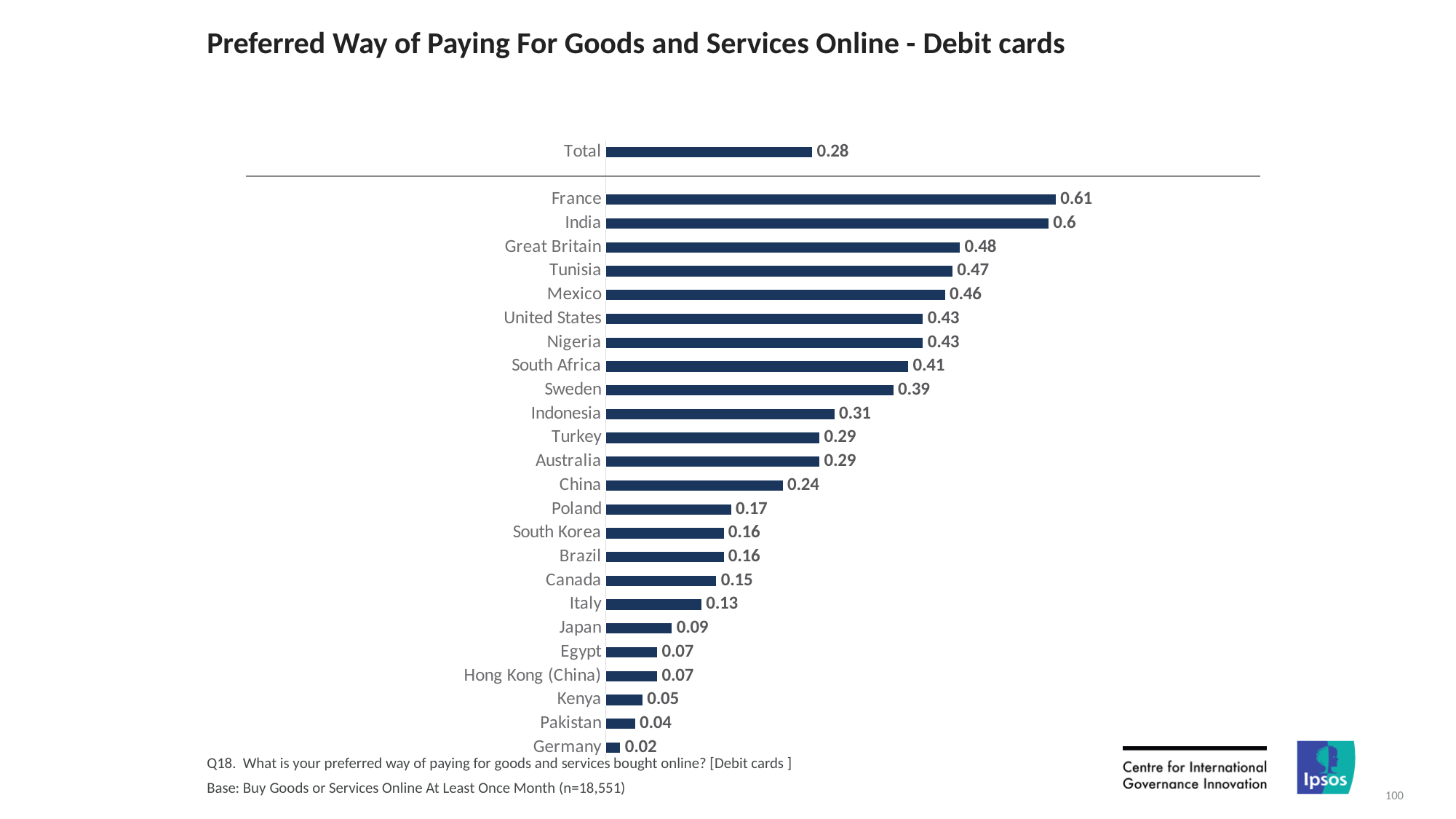
What is the value for France? 0.61 What is the value for Total? 0.28 Which has a larger value, Mexico or Indonesia? Mexico Do the country values increase or decrease going down the chart from France to Germany? Decrease What is the title of the chart? Preferred Way of Paying For Goods and Services Online - Debit cards Which country has the highest value? France What kind of chart is shown on the slide? Bar chart What is the value for Sweden? 0.39 What is the value for Hong Kong (China)? 0.07 Which country has the lowest value? Germany What is the difference between the values for Great Britain and Canada? 0.33 How many countries are listed below the Total bar? 24